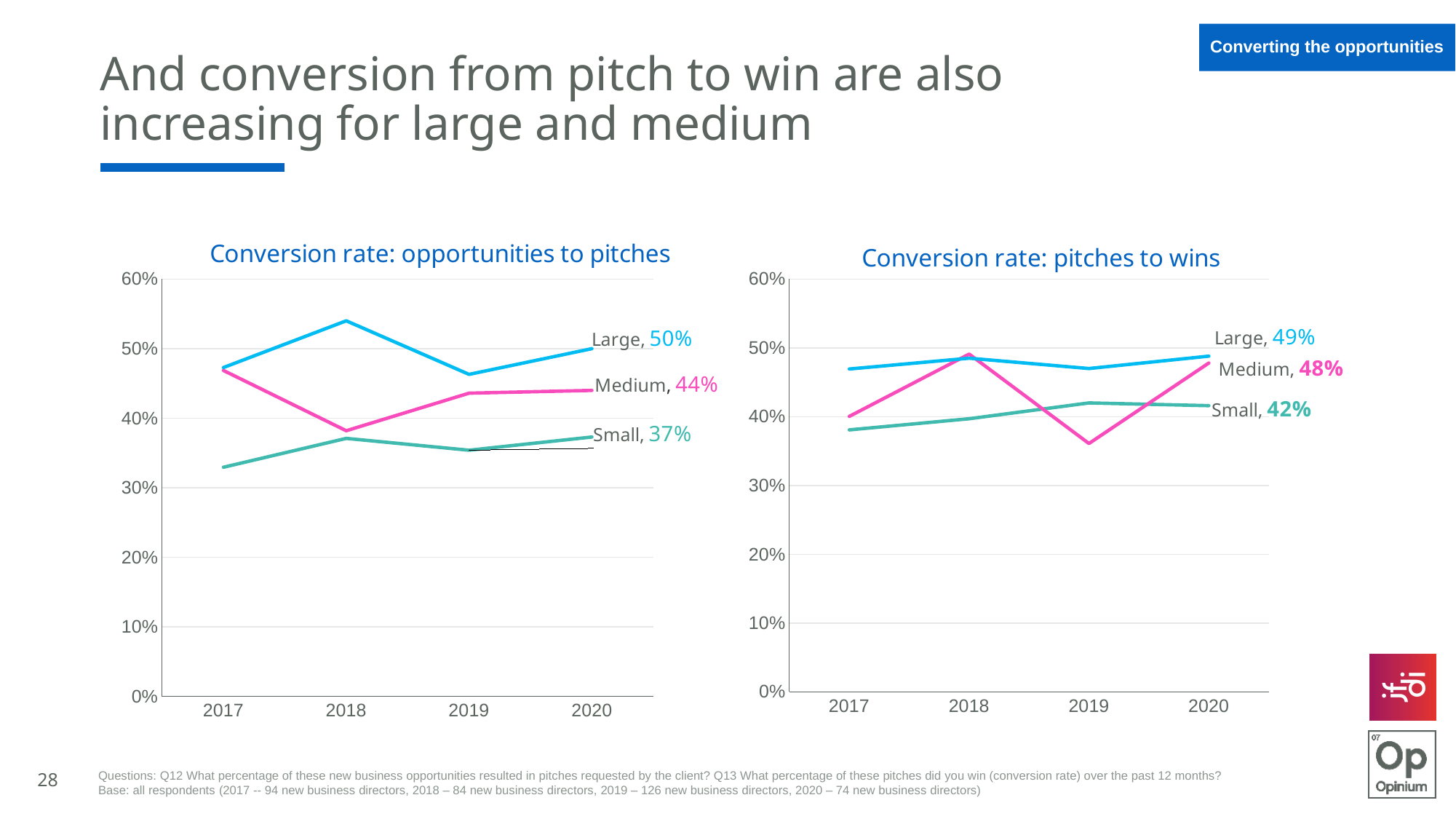
In the chart titled 'Conversion rate: opportunities to pitches', what is the difference between the Large and Small values in 2020? 13 percentage points In the chart titled 'Conversion rate: pitches to wins', which is larger in 2020, Medium or Small? Medium In the chart titled 'Conversion rate: opportunities to pitches', which series has the lowest value in 2020? Small In the chart titled 'Conversion rate: pitches to wins', is the value for Medium in 2019 greater or less than 40%? less In the chart titled 'Conversion rate: opportunities to pitches', what is the value for Large in 2020? 50% In the chart titled 'Conversion rate: pitches to wins', what is the value for Medium in 2020? 48% In the chart titled 'Conversion rate: opportunities to pitches', is the value for Large in 2018 greater or less than 50%? greater What kind of chart is the chart titled 'Conversion rate: opportunities to pitches'? Line chart How many years are shown on the x axis of the chart titled 'Conversion rate: pitches to wins'? 4 In the chart titled 'Conversion rate: opportunities to pitches', what is the value for Medium in 2020? 44% In the chart titled 'Conversion rate: pitches to wins', which series has the highest value in 2020? Large In the chart titled 'Conversion rate: pitches to wins', what is the value for Small in 2020? 42%